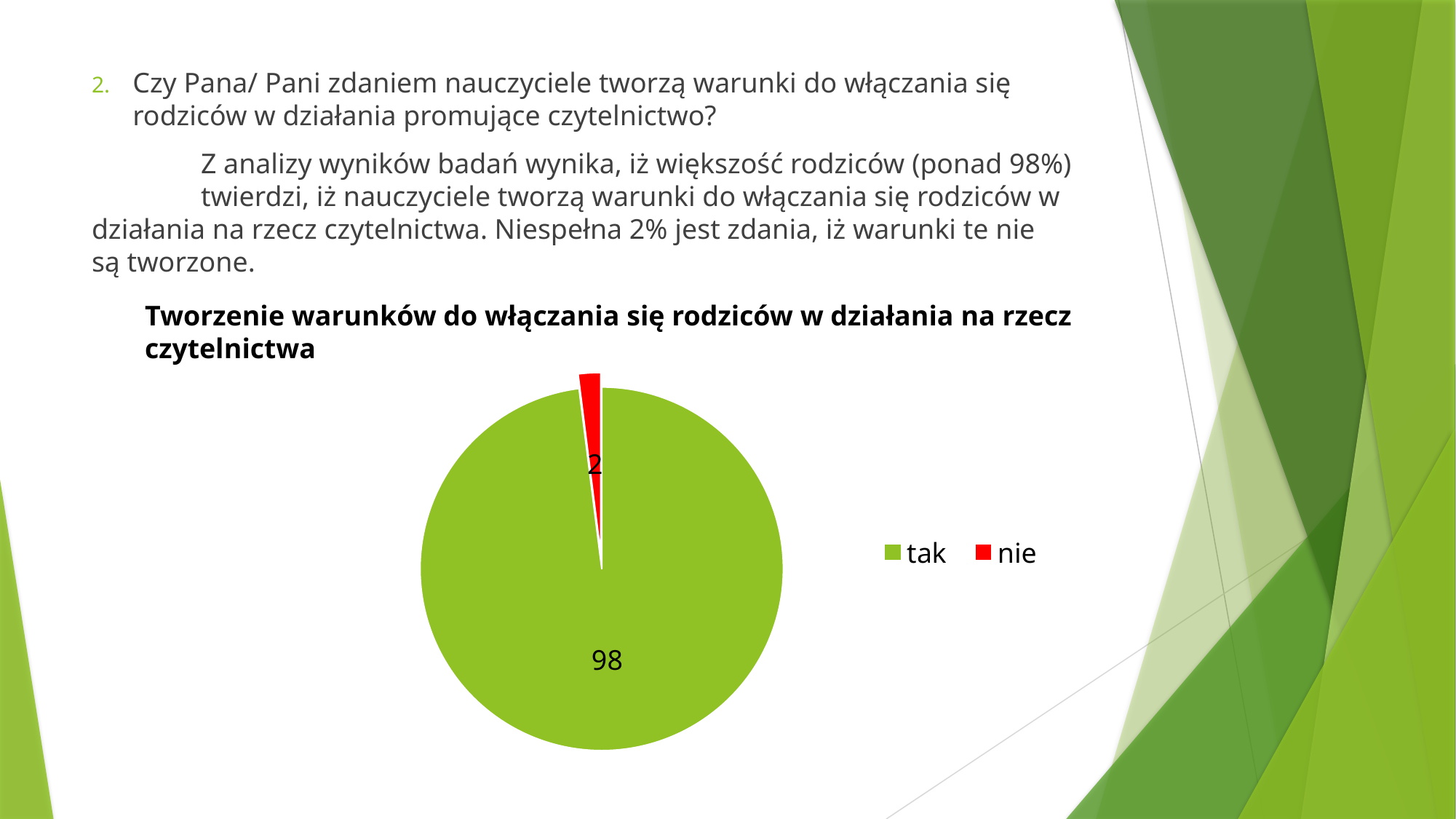
What is the total of the two values shown in the pie chart? 100 What is the value for "nie" in the pie chart? 2 What colour is the "nie" slice in the pie chart? red Which is larger, the value for "tak" or the value for "nie"? tak What kind of chart is shown on the slide? pie chart How many categories does the pie chart show? 2 Which category has the smallest slice in the pie chart? nie What is the value for "tak" in the pie chart? 98 What is the difference between the values for "tak" and "nie"? 96 Which category has the largest slice in the pie chart? tak What is the title of the chart? Tworzenie warunków do włączania się rodziców w działania na rzecz czytelnictwa